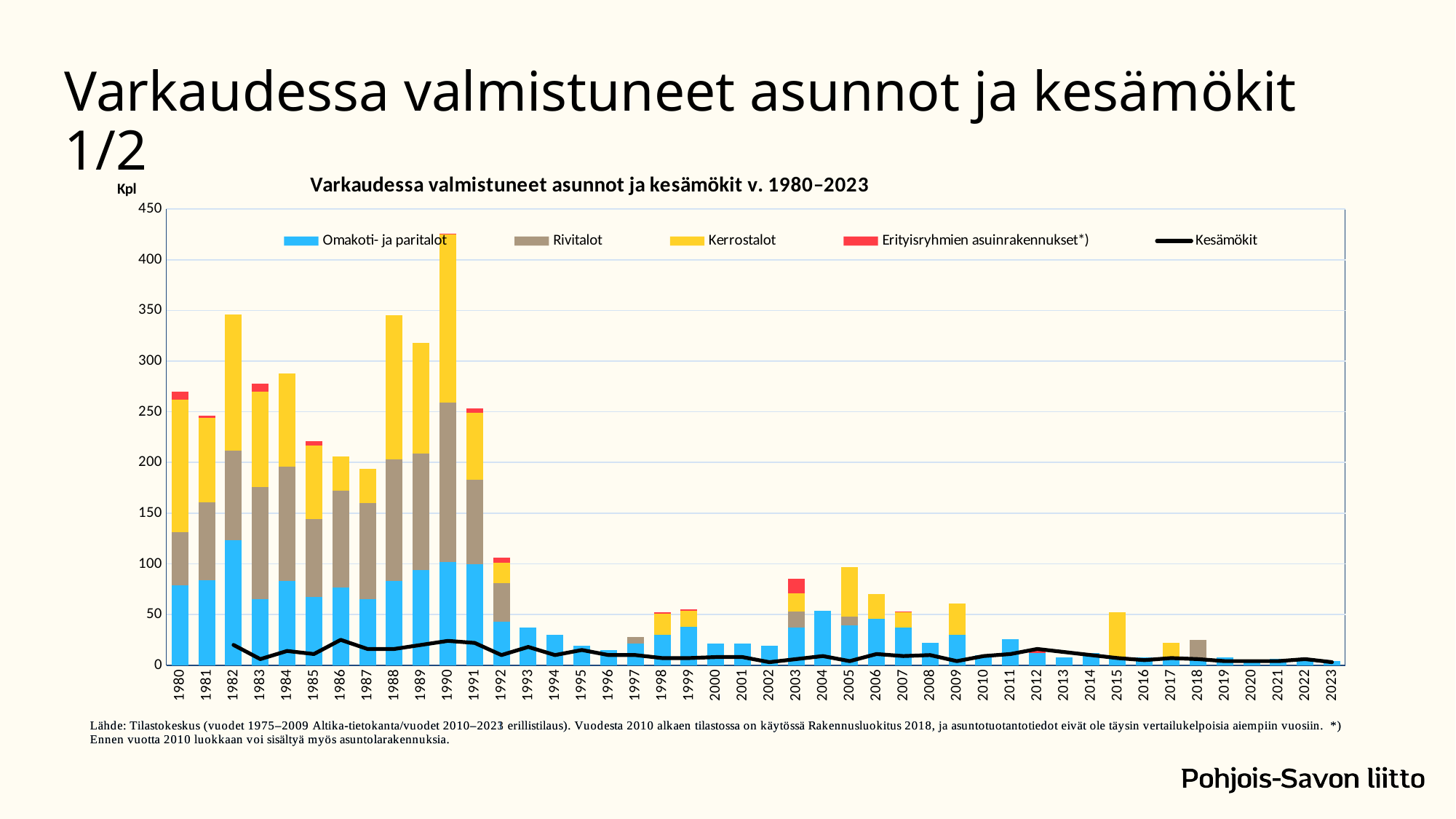
Is the total stacked bar for 1993 greater or less than 50? less Which year has the taller stacked bar, 1982 or 1983? 1982 How many years are shown on the x axis? 44 Which year has the tallest stacked bar? 1990 Is the total stacked bar for 2005 greater or less than 50? greater Is the total stacked bar for 1990 greater or less than 400? greater What kind of chart is shown on the slide? Stacked bar chart with a line Which series is drawn as the black line? Kesämökit How many series does the legend list? 5 Which year has the taller stacked bar, 2004 or 2005? 2005 Do the stacked bar totals generally rise or fall from 1980 to 2023? Fall